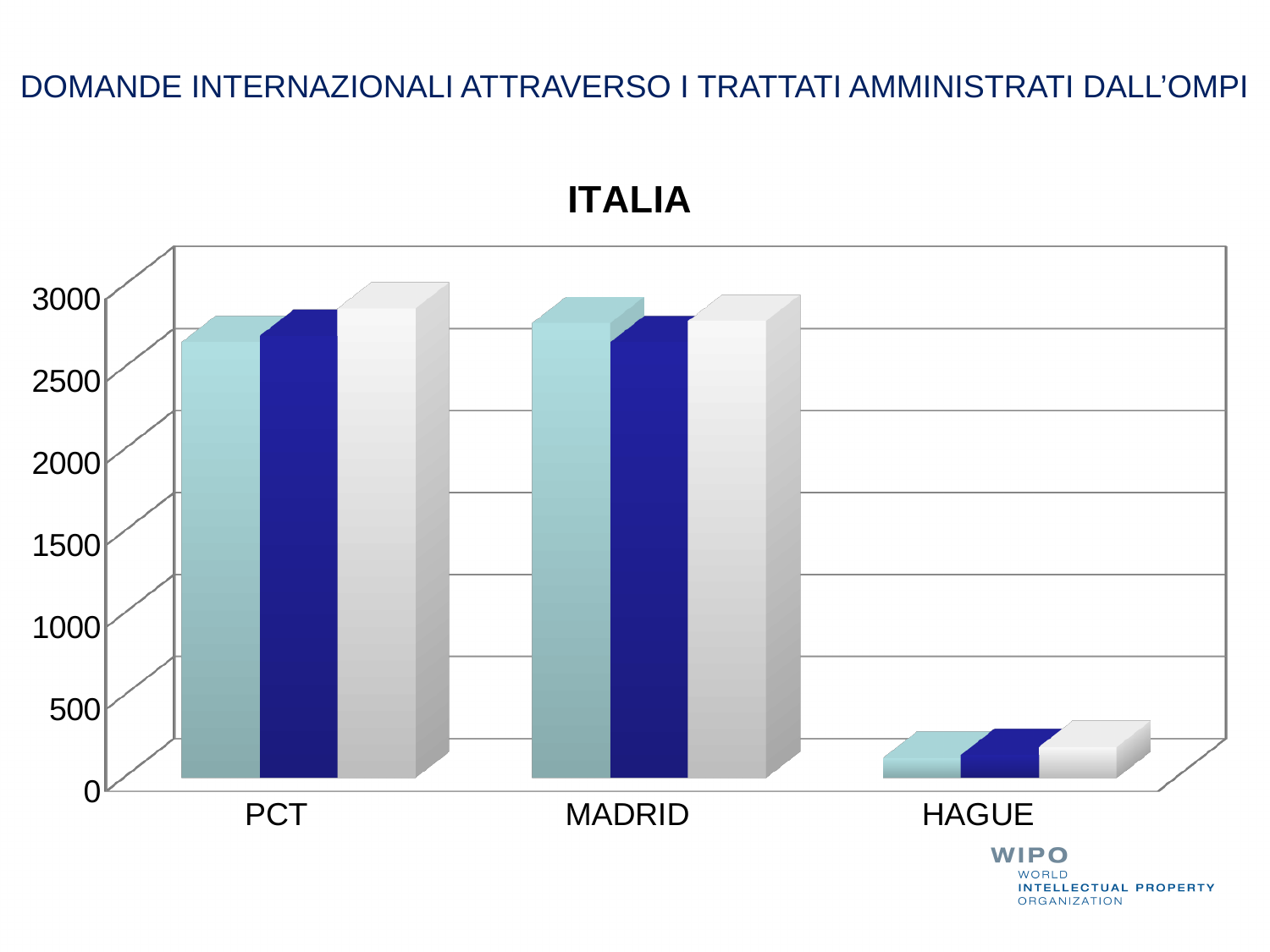
What is the label of the first category on the x axis? PCT Are the values for MADRID greater or less than 2500? greater Which category has the lowest values in the chart? HAGUE Are the values for HAGUE greater or less than 500? less Which category has larger values, PCT or HAGUE? PCT What is the title of the chart? ITALIA How many bars are plotted for each category in the chart? 3 Which category has larger values, MADRID or HAGUE? MADRID What is the highest value shown on the y axis of the chart? 3000 How many categories are shown on the x axis of the chart? 3 What kind of chart is shown on the slide? bar chart Are the values for PCT greater or less than 2000? greater